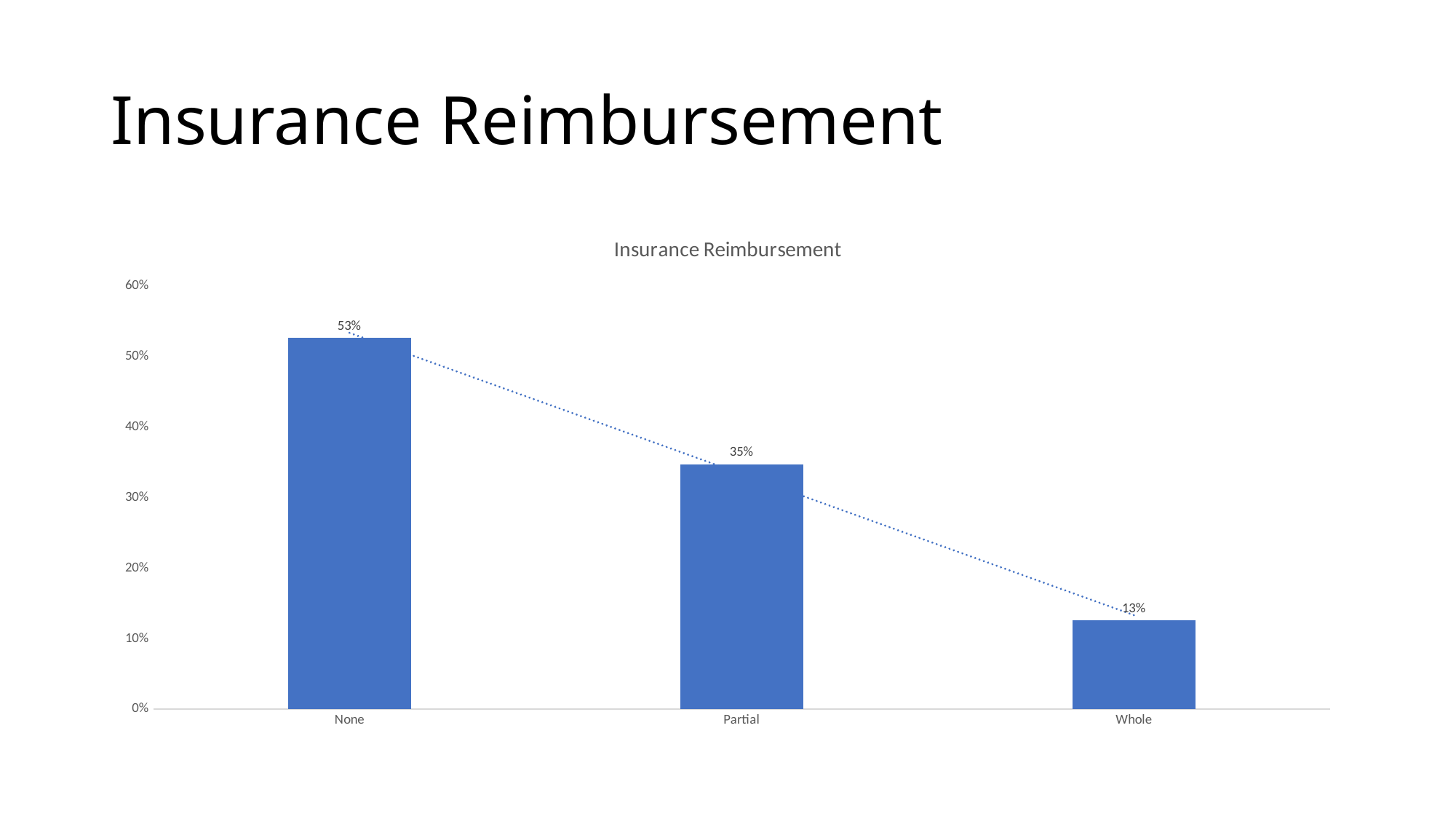
What is the difference between the values for None and Partial? 18% Do the values rise or fall from None to Whole? fall What is the value for None? 53% What is the difference between the values for Partial and Whole? 22% Is the value for Partial greater or less than 40%? less Which category has the lowest value? Whole How many categories are shown on the x axis? 3 Which category has the highest value? None What kind of chart is this? bar chart What is the value for Partial? 35% Which is larger, the value for Partial or the value for Whole? Partial What is the value for Whole? 13%